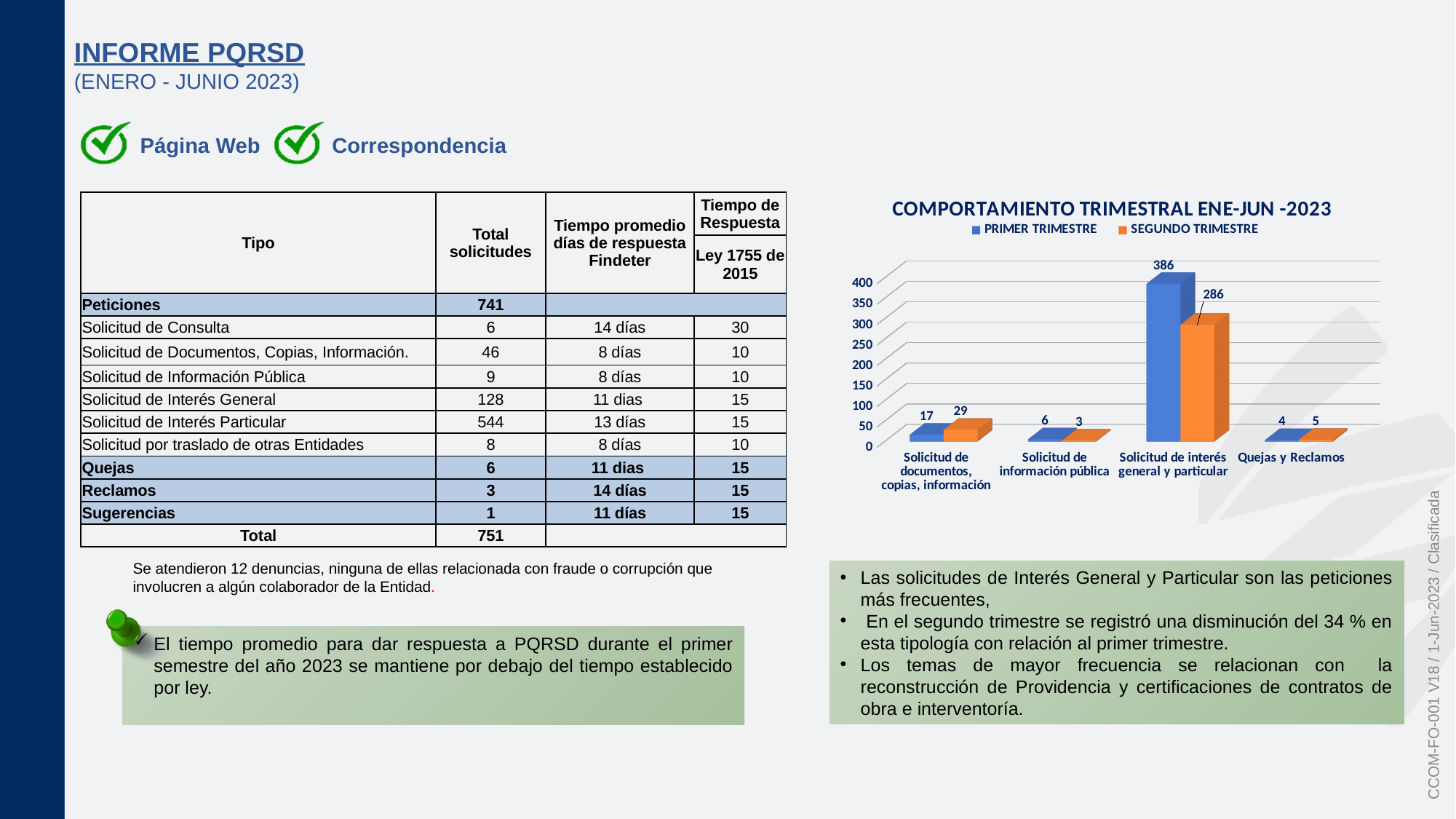
Which category has the lowest value for SEGUNDO TRIMESTRE? Solicitud de información pública How many categories are shown on the x axis of the chart? 4 How many series does the chart legend list? 2 What is the difference between the PRIMER TRIMESTRE and SEGUNDO TRIMESTRE values for 'Solicitud de interés general y particular'? 100 For 'Solicitud de documentos, copias, información', which is larger: PRIMER TRIMESTRE or SEGUNDO TRIMESTRE? SEGUNDO TRIMESTRE What is the value for PRIMER TRIMESTRE in the 'Solicitud de interés general y particular' category? 386 What is the value for SEGUNDO TRIMESTRE in the 'Solicitud de información pública' category? 3 What is the title of the chart? COMPORTAMIENTO TRIMESTRAL ENE-JUN -2023 What is the value for SEGUNDO TRIMESTRE in the 'Solicitud de documentos, copias, información' category? 29 What is the value for PRIMER TRIMESTRE in the 'Quejas y Reclamos' category? 4 Which category has the highest value for PRIMER TRIMESTRE? Solicitud de interés general y particular What kind of chart is shown on the slide? Bar chart